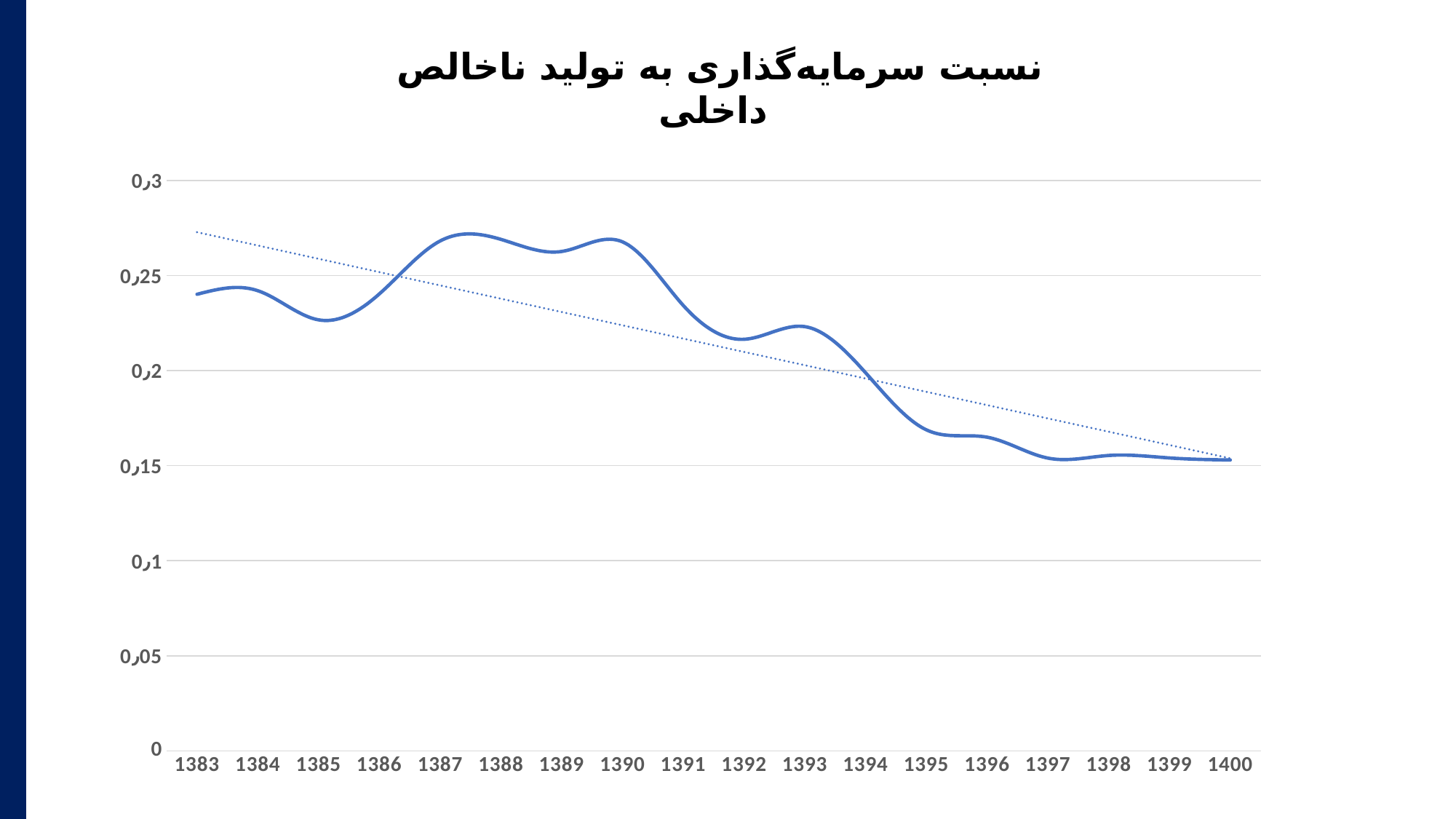
Which is larger, the value for 1390 or the value for 1393? 1390 Overall, do the values rise or fall from 1383 to 1400? fall Is the value for 1392 greater or less than 0,25? less What kind of chart is shown on the slide? line chart Which is larger, the value for 1388 or the value for 1395? 1388 Is the value for 1395 greater or less than 0,2? less Is the value for 1388 greater or less than 0,25? greater Which is larger, the value for 1383 or the value for 1400? 1383 What is the highest value shown on the y axis? 0,3 How many years are plotted along the x axis? 18